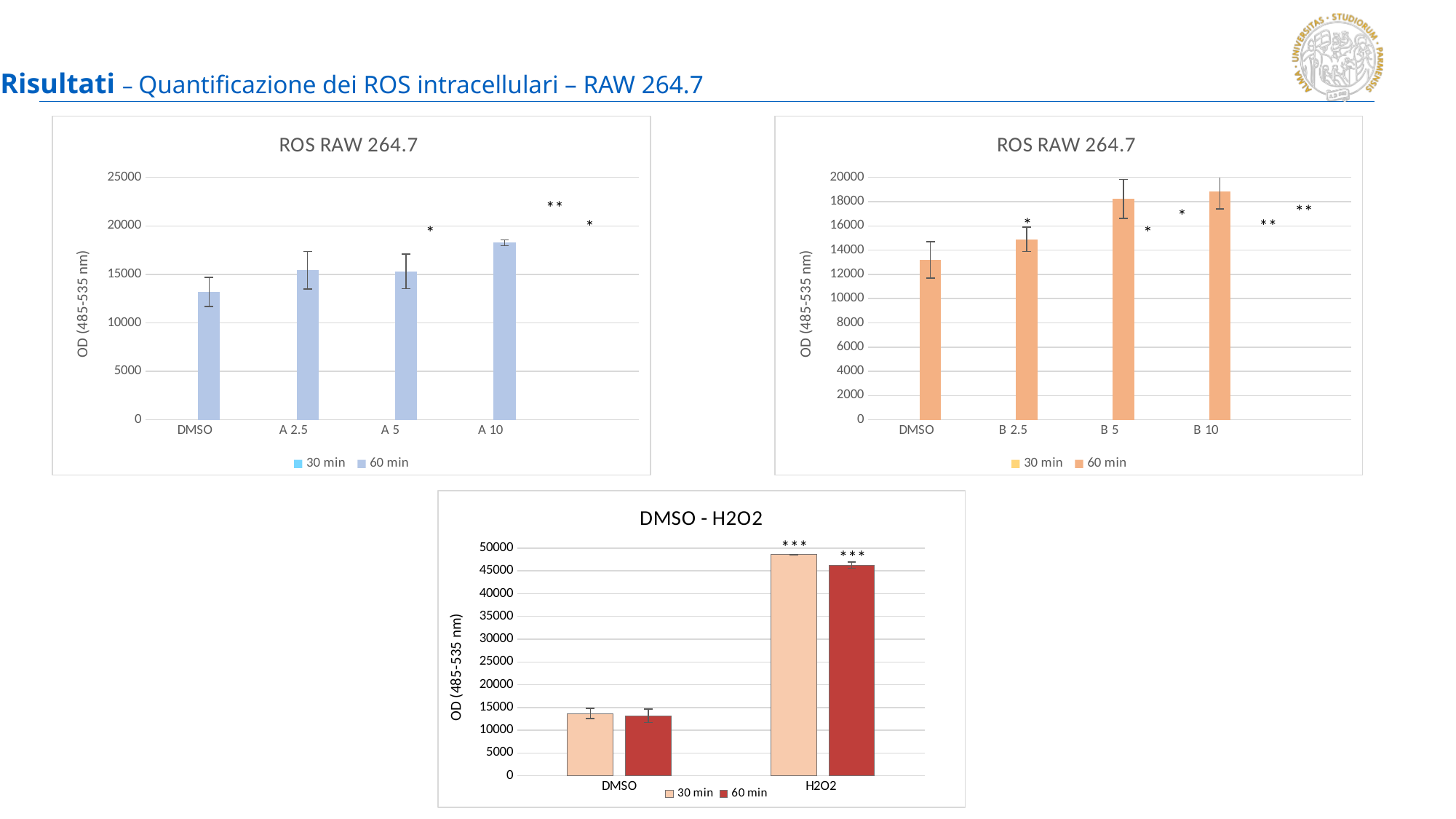
In the right chart titled ROS RAW 264.7, which is larger, the 60 min value for B 5 or for DMSO? B 5 In the left chart titled ROS RAW 264.7, is the 60 min value for DMSO greater or less than 15000? less In the left chart titled ROS RAW 264.7, which category has the lowest 60 min value? DMSO How many categories are shown on the x axis of the left chart titled ROS RAW 264.7? 4 In the right chart titled ROS RAW 264.7, which category has the lowest 60 min value? DMSO In the chart titled DMSO - H2O2, which is larger, the 60 min value for H2O2 or for DMSO? H2O2 In the left chart titled ROS RAW 264.7, is the 60 min value for A 10 greater or less than 15000? greater In the chart titled DMSO - H2O2, is the 30 min value for H2O2 greater or less than 45000? greater What kind of chart is the chart titled DMSO - H2O2? bar chart How many series does the legend of the right chart titled ROS RAW 264.7 list? 2 In the left chart titled ROS RAW 264.7, which category has the highest 60 min value? A 10